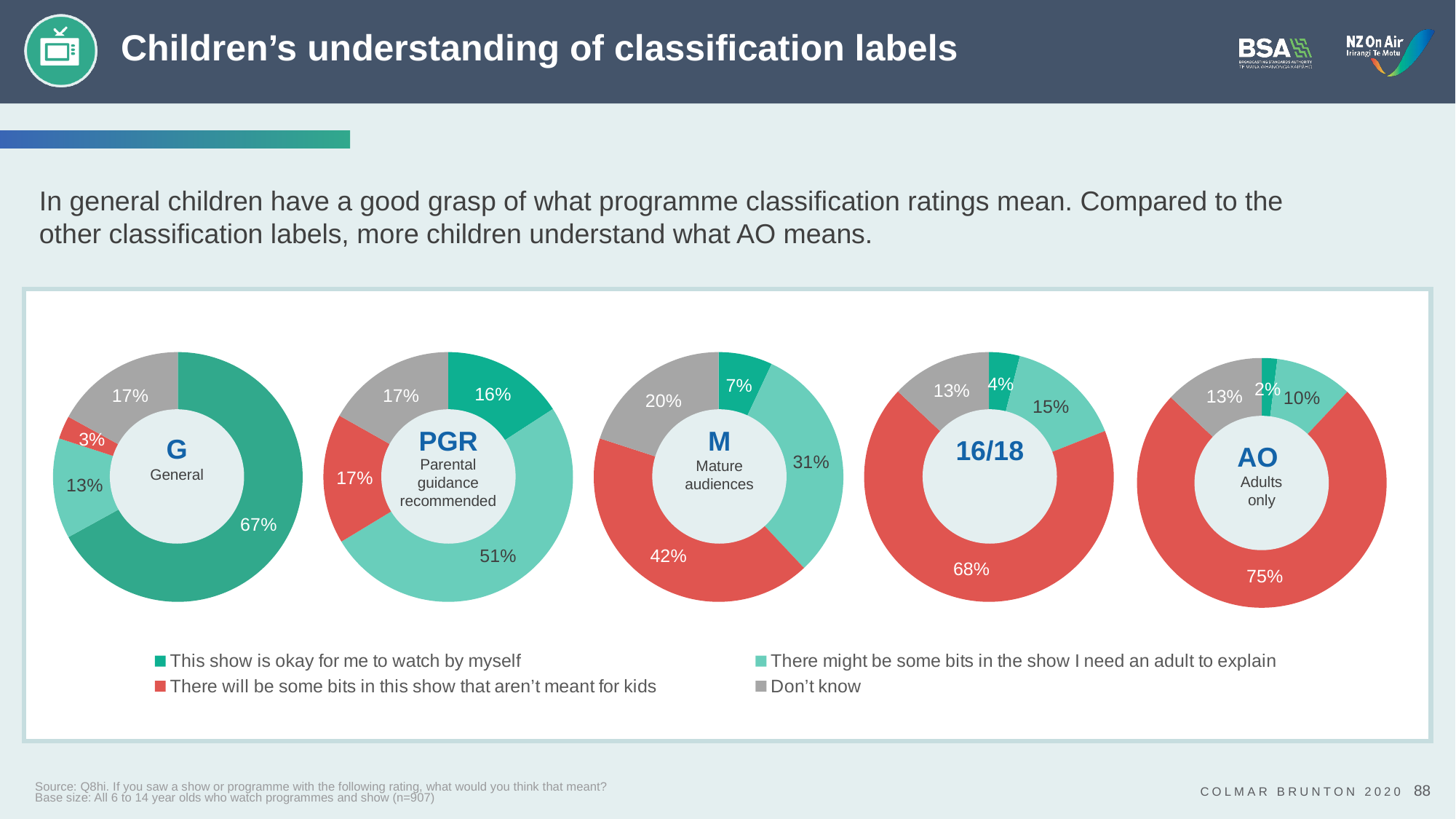
In the AO (Adults only) donut chart, what percentage of children said "There will be some bits in this show that aren't meant for kids"? 75% How many response categories does the legend list? 4 In the G (General) donut chart, what percentage of children said "This show is okay for me to watch by myself"? 67% In the M (Mature audiences) donut chart, what percentage of children answered "Don't know"? 20% What type of chart is used to show children's understanding of each classification label? Donut (pie) chart Which chart has the larger "Don't know" share, the M chart or the 16/18 chart? M In the 16/18 donut chart, which response has the largest share? There will be some bits in this show that aren't meant for kids How many donut charts are shown on the slide? 5 In the PGR donut chart, what percentage of children said "There might be some bits in the show I need an adult to explain"? 51% In the G (General) donut chart, which response has the smallest share? There will be some bits in this show that aren't meant for kids In the AO donut chart, what percentage of children said "This show is okay for me to watch by myself"? 2% What is the difference between the "okay for me to watch by myself" share in the G chart and in the PGR chart? 51 percentage points